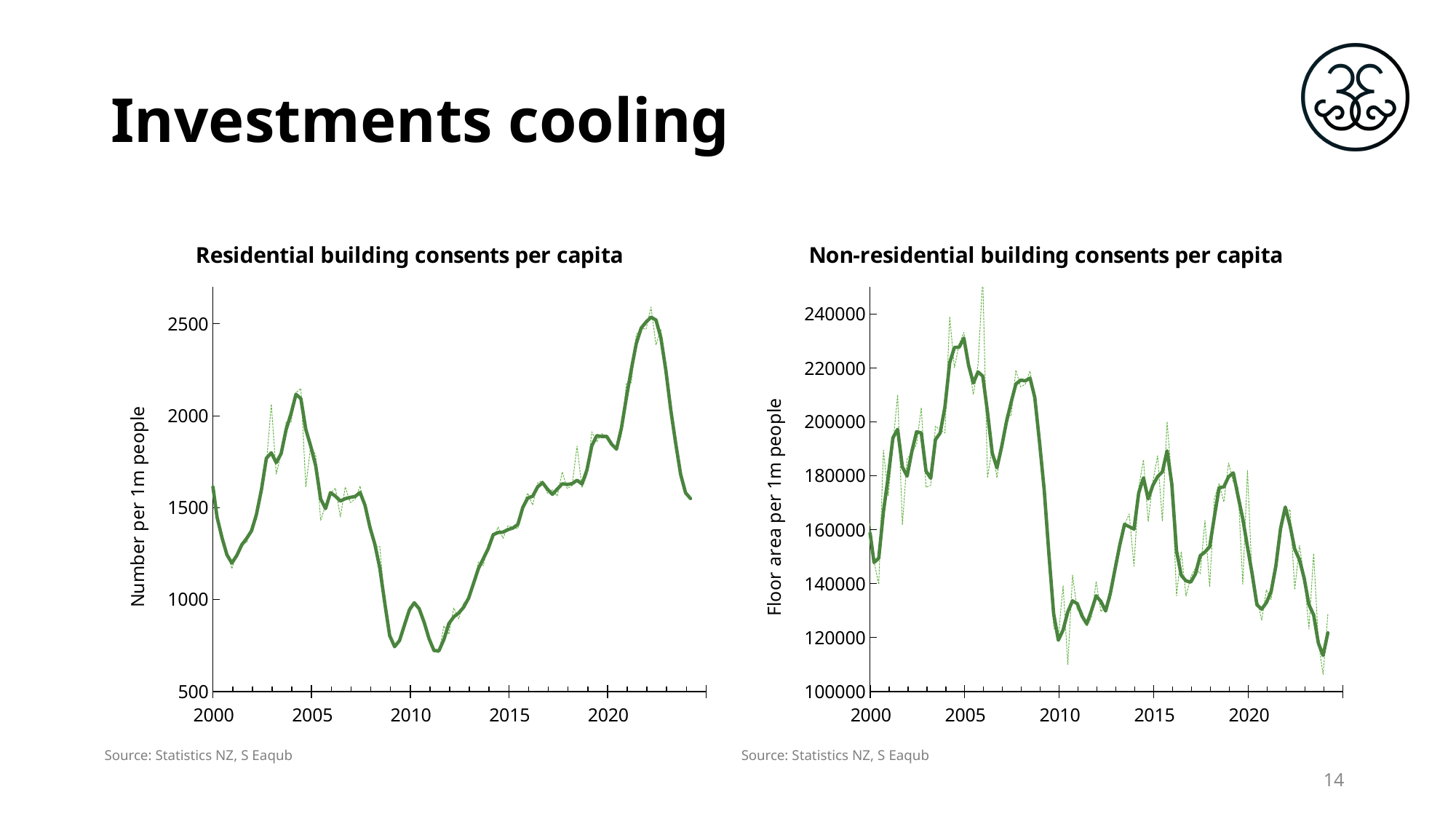
In the 'Residential building consents per capita' chart, does the smoothed line rise or fall between 2022 and 2024? fall What kind of chart is the 'Non-residential building consents per capita' chart? line chart What is the y-axis label of the 'Non-residential building consents per capita' chart? Floor area per 1m people How many charts are shown on the slide? 2 In the 'Non-residential building consents per capita' chart, is the value around 2010 greater or less than 140000? less What kind of chart is the 'Residential building consents per capita' chart? line chart In the 'Residential building consents per capita' chart, is the value at 2020 greater or less than 1500? greater In the 'Non-residential building consents per capita' chart, is the peak value around 2005 greater or less than 220000? greater In the 'Non-residential building consents per capita' chart, does the smoothed line rise or fall between 2005 and 2010? fall What is the y-axis label of the 'Residential building consents per capita' chart? Number per 1m people